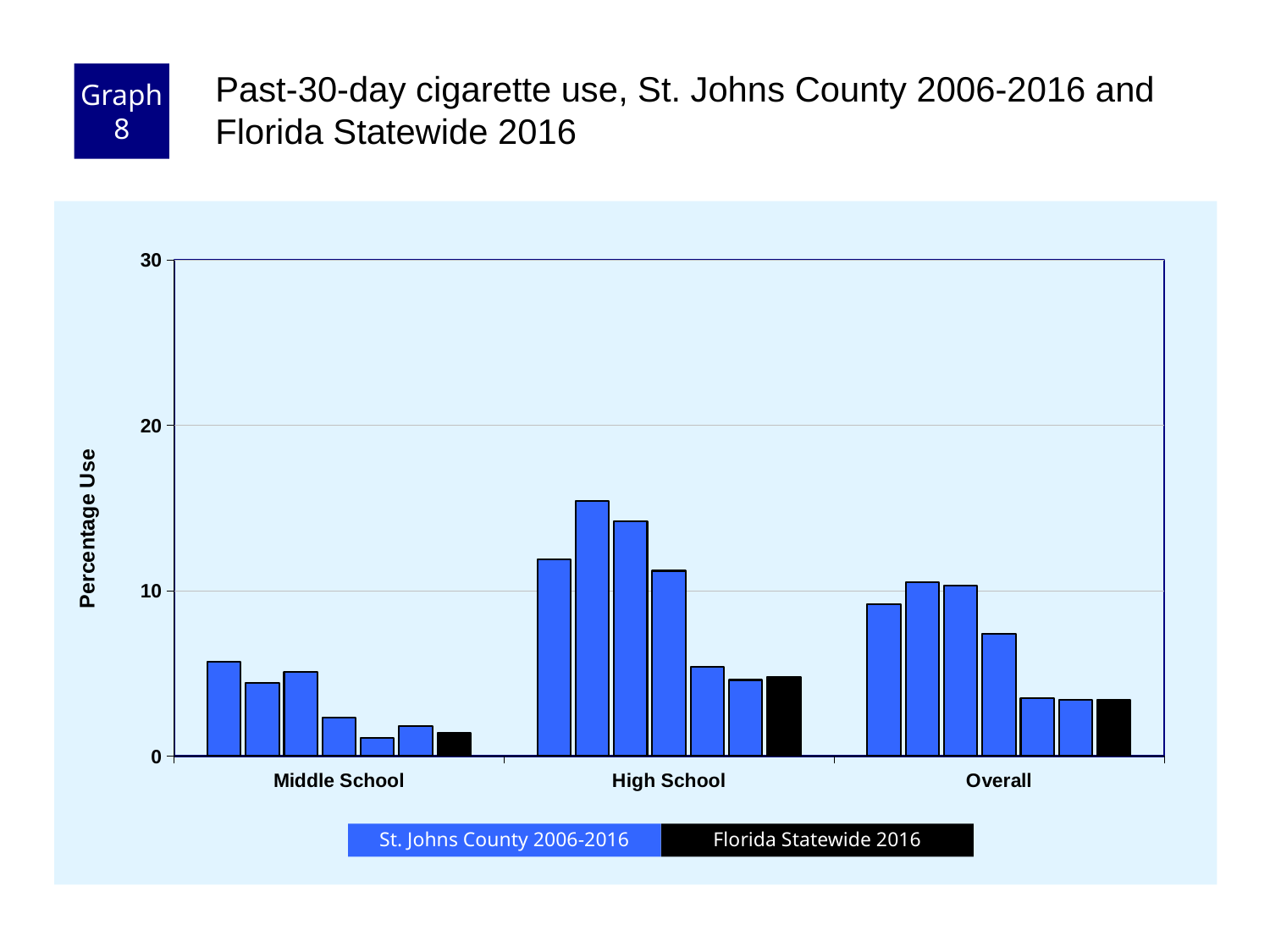
Is the Florida Statewide 2016 bar for High School greater or less than 10? less Is the Florida Statewide 2016 bar larger for High School or for Middle School? High School Which category group has the lowest bars overall? Middle School What kind of chart is shown on the slide? bar chart How many series does the legend list? 2 Is the tallest bar in the Middle School group greater or less than 10? less How many bars are plotted in the High School group? 7 Is the tallest bar in the Overall group greater or less than 20? less What is the label on the y axis? Percentage Use How many category groups are shown on the x axis? 3 Which category group contains the tallest bar on the chart? High School